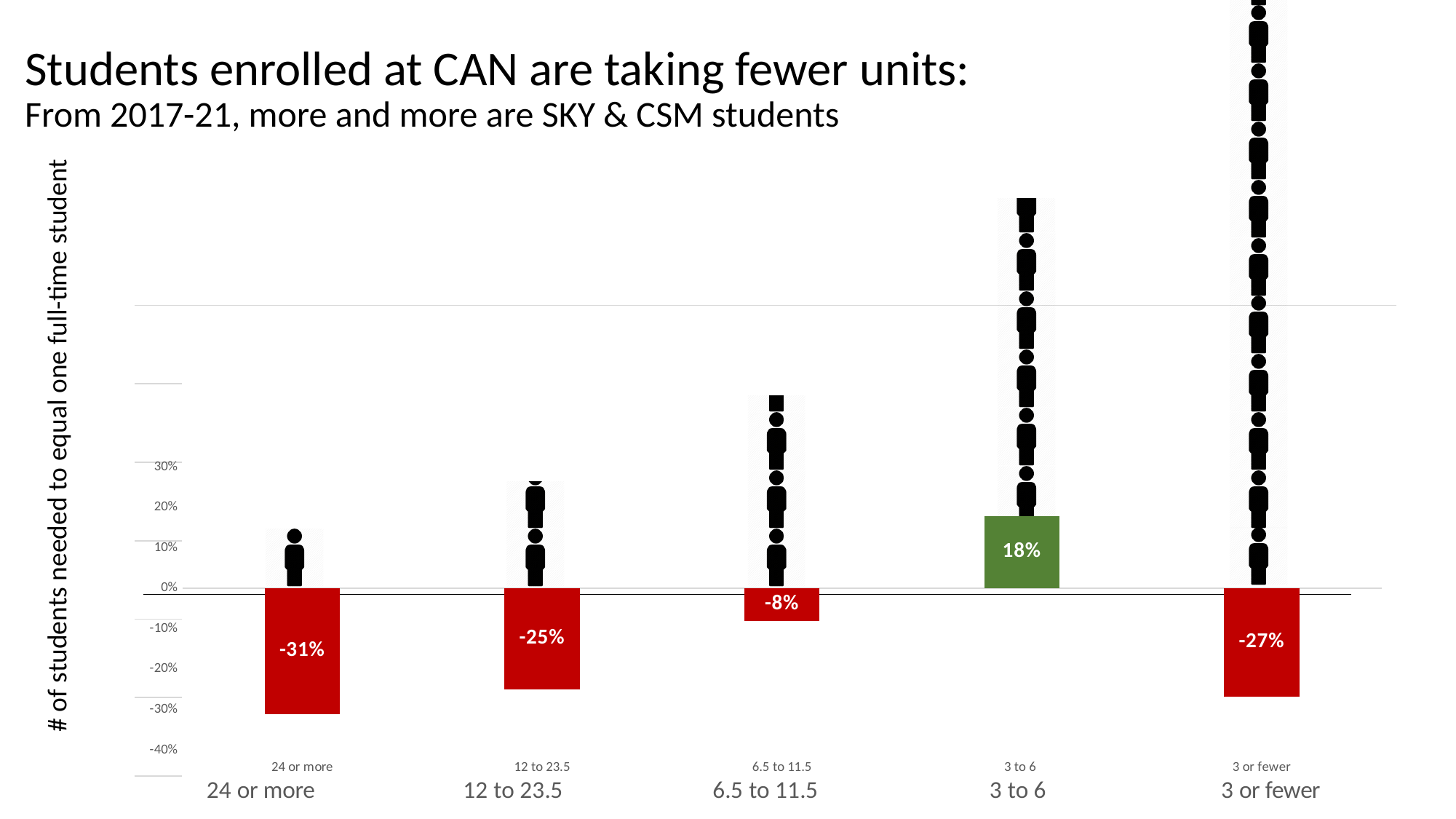
Which is larger, the value for "12 to 23.5" or the value for "3 or fewer"? 12 to 23.5 How many categories are shown on the x axis? 5 Which category has the highest value? 3 to 6 What is the label on the vertical axis? # of students needed to equal one full-time student What is the value shown for the "3 to 6" category? 18% Which category is the only one shown with a green bar? 3 to 6 What is the value shown for the "24 or more" category? -31% What is the value shown for the "3 or fewer" category? -27% What is the difference between the values for "12 to 23.5" and "6.5 to 11.5"? 17 percentage points Which category has the lowest value? 24 or more What kind of chart is shown on the slide? Bar chart What is the value shown for the "6.5 to 11.5" category? -8%